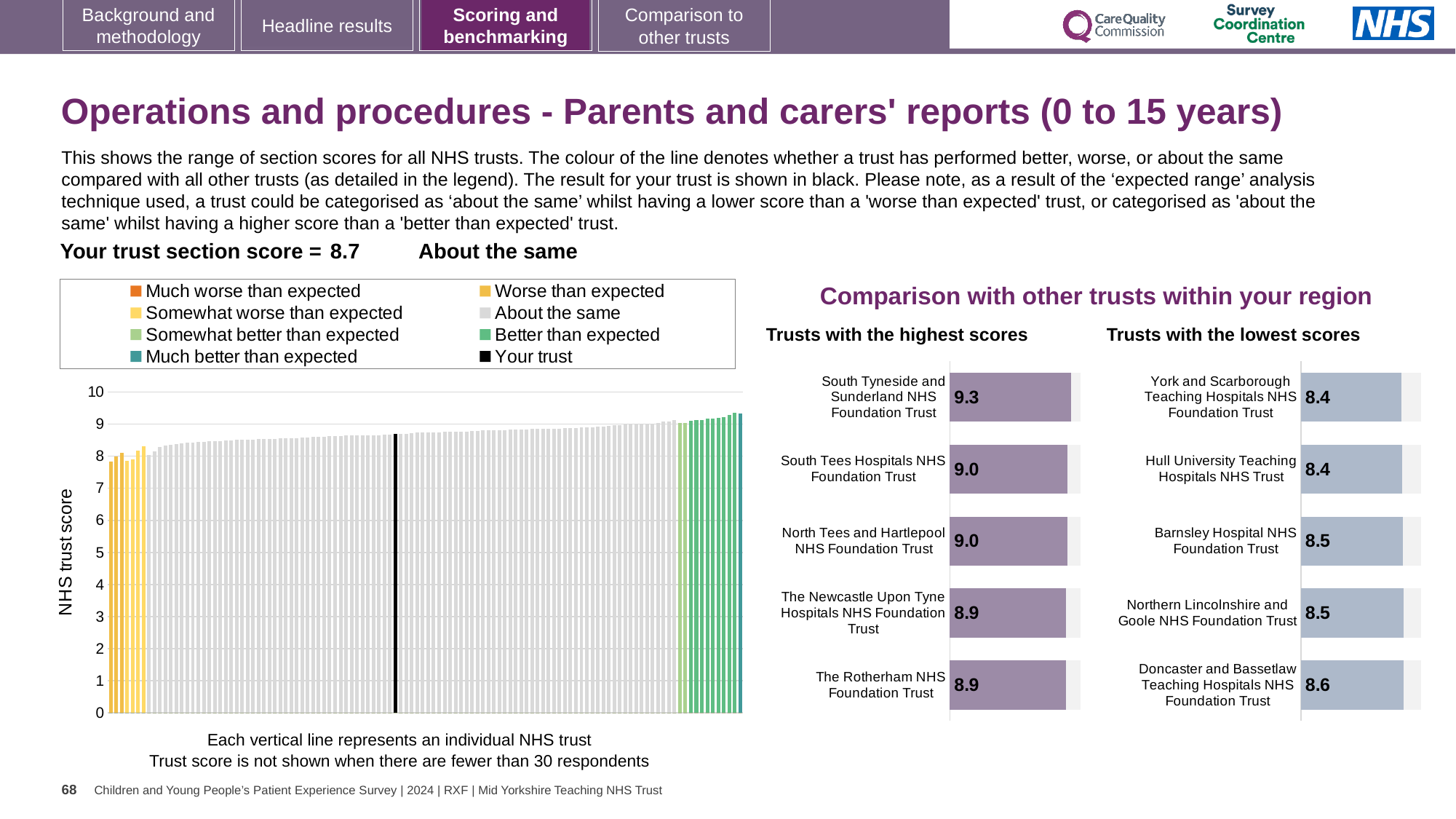
In the 'NHS trust score' chart on the left, do the bar values rise or fall from left to right along the x axis? rise In the 'Trusts with the highest scores' chart, which trust has the highest score? South Tyneside and Sunderland NHS Foundation Trust What is the label on the y axis of the large chart on the left? NHS trust score In the 'Trusts with the highest scores' chart, what is the score for South Tyneside and Sunderland NHS Foundation Trust? 9.3 In the 'NHS trust score' chart on the left, is the value for the black 'Your trust' bar greater or less than 8? greater In the 'Trusts with the highest scores' chart, how many trusts are shown? 5 In the 'NHS trust score' chart on the left, how many entries does the legend list? 8 In the 'Trusts with the lowest scores' chart, which is larger: the score for Doncaster and Bassetlaw Teaching Hospitals NHS Foundation Trust or the score for Hull University Teaching Hospitals NHS Trust? Doncaster and Bassetlaw Teaching Hospitals NHS Foundation Trust In the 'Trusts with the highest scores' chart, what is the difference between the scores of South Tyneside and Sunderland NHS Foundation Trust and The Rotherham NHS Foundation Trust? 0.4 In the 'Trusts with the lowest scores' chart, which trust has the highest score? Doncaster and Bassetlaw Teaching Hospitals NHS Foundation Trust What kind of chart is the large chart on the left with the y axis labelled 'NHS trust score'? bar chart In the 'Trusts with the lowest scores' chart, what is the score for Barnsley Hospital NHS Foundation Trust? 8.5